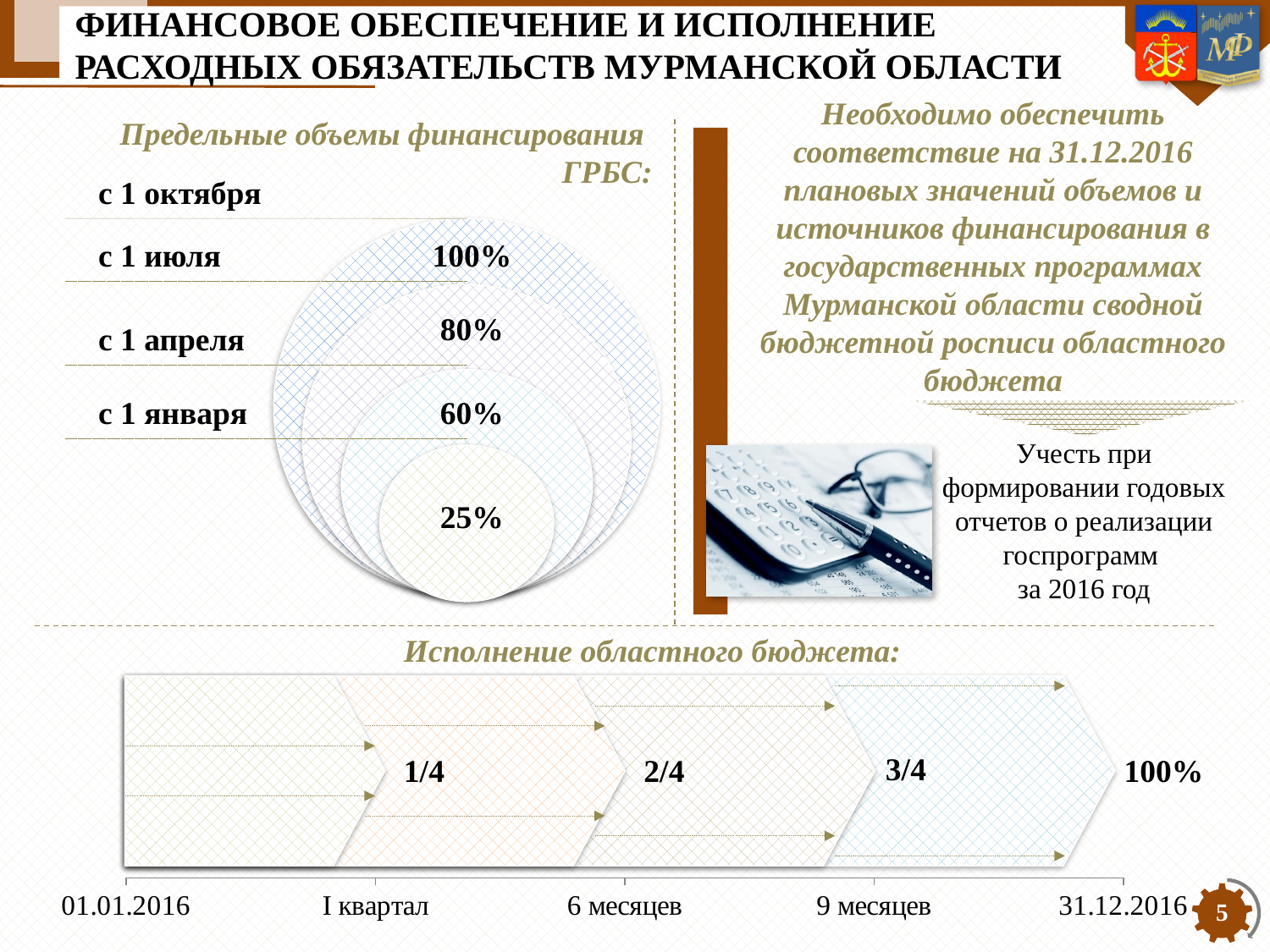
In the 'Исполнение областного бюджета' diagram, what is the last date label on the timeline axis? 31.12.2016 In the 'Предельные объемы финансирования ГРБС' diagram, what percentage is shown for 'с 1 октября'? 100% In the 'Предельные объемы финансирования ГРБС' diagram, which date has the lowest percentage? с 1 января In the 'Предельные объемы финансирования ГРБС' diagram, do the percentages rise or fall from 'с 1 января' to 'с 1 октября'? rise In the 'Предельные объемы финансирования ГРБС' diagram, what is the difference between the percentages for 'с 1 октября' and 'с 1 января'? 75% In the 'Предельные объемы финансирования ГРБС' diagram, what percentage is shown for 'с 1 января'? 25% In the 'Исполнение областного бюджета' diagram, what label is shown on the segment ending at '9 месяцев'? 3/4 In the 'Предельные объемы финансирования ГРБС' diagram, which date has the highest percentage? с 1 октября In the 'Предельные объемы финансирования ГРБС' diagram, what percentage is shown for 'с 1 июля'? 80% In the 'Исполнение областного бюджета' diagram at the bottom, how many arrow segments are shown? 4 In the 'Предельные объемы финансирования ГРБС' diagram, how many nested circles (percentage levels) are shown? 4 In the 'Предельные объемы финансирования ГРБС' diagram, what percentage is shown for 'с 1 апреля'? 60%